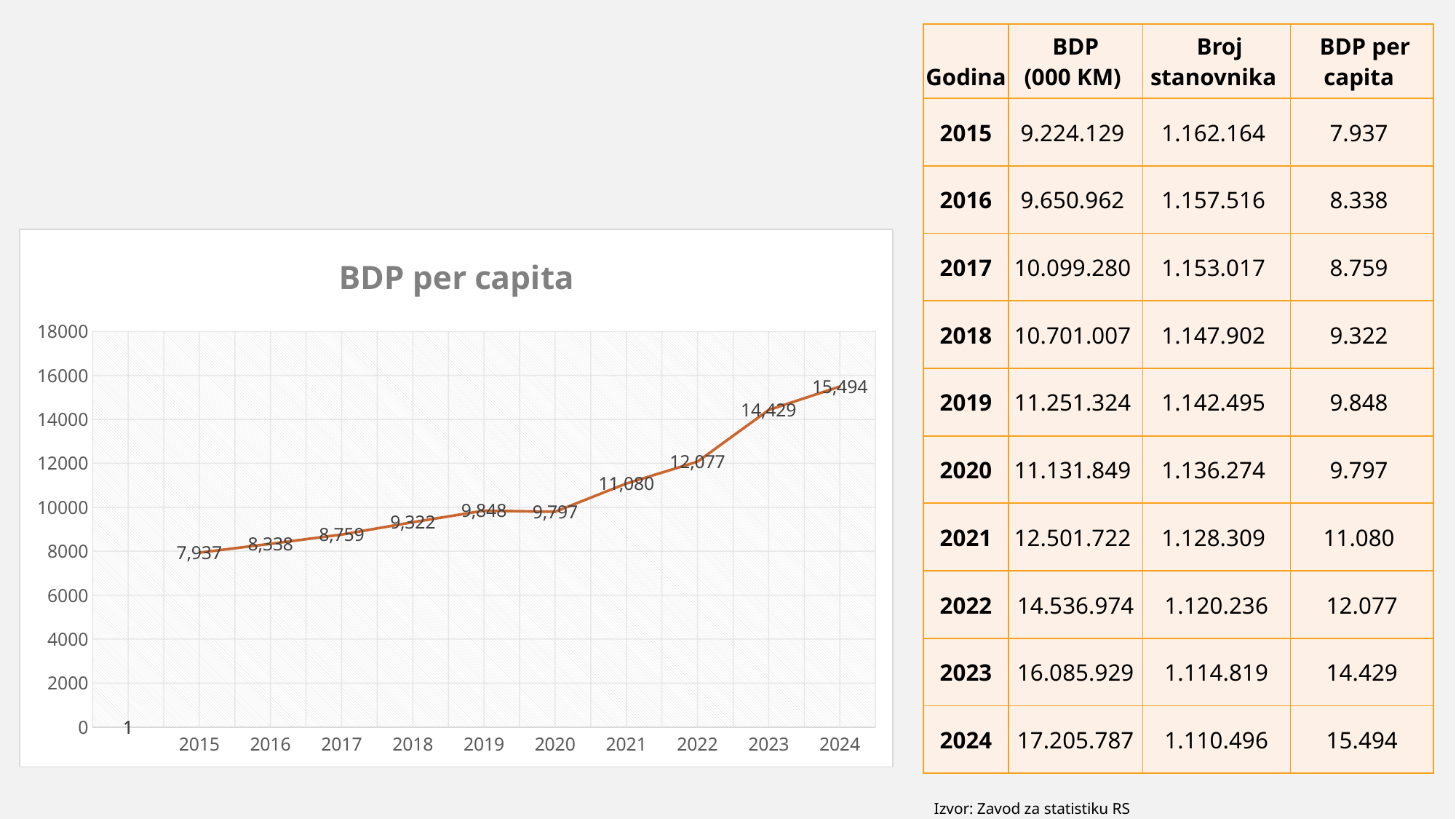
Which year has the highest BDP per capita in the chart? 2024 Does the BDP per capita generally rise or fall from 2015 to 2024? rise How many years are plotted on the x axis of the chart, from 2015 to 2024? 10 What type of chart is shown on the slide? line chart What is the BDP per capita value for 2015 in the chart? 7,937 Which is larger, the BDP per capita for 2019 or for 2020? 2019 What is the title of the chart? BDP per capita What is the difference between the BDP per capita values for 2024 and 2023? 1,065 What is the BDP per capita value for 2023 in the chart? 14,429 Which year has the lowest BDP per capita in the chart? 2015 What is the BDP per capita value for 2020 in the chart? 9,797 Is the BDP per capita value for 2022 greater or less than 10000? greater